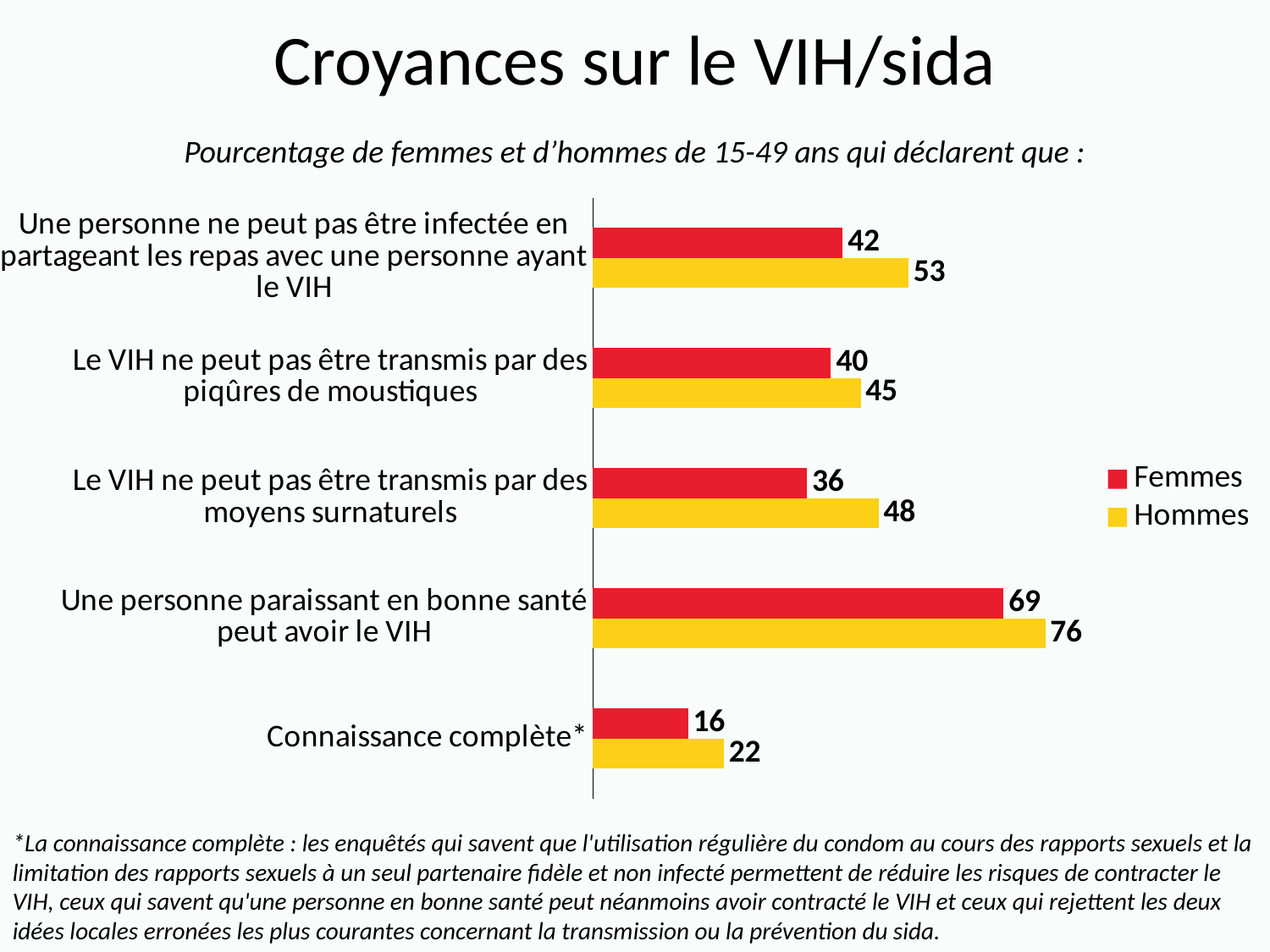
How many series does the legend list? 2 What kind of chart is shown on the slide? Bar chart What is the value for Femmes for 'Connaissance complète*'? 16 What percentage of men (Hommes) report that HIV cannot be transmitted by mosquito bites (piqûres de moustiques)? 45 What is the difference between Hommes and Femmes for 'Une personne ne peut pas être infectée en partageant les repas avec une personne ayant le VIH'? 11 Which colour represents Hommes in the chart? Yellow Which category has the lowest value for Femmes? Connaissance complète* Which category has the highest value for Hommes? Une personne paraissant en bonne santé peut avoir le VIH For 'Connaissance complète*', which is larger, the value for Femmes or for Hommes? Hommes What percentage of women (Femmes) report that a healthy-looking person can have HIV (Une personne paraissant en bonne santé peut avoir le VIH)? 69 What is the difference between Hommes and Femmes for 'Le VIH ne peut pas être transmis par des moyens surnaturels'? 12 How many categories are shown on the chart? 5